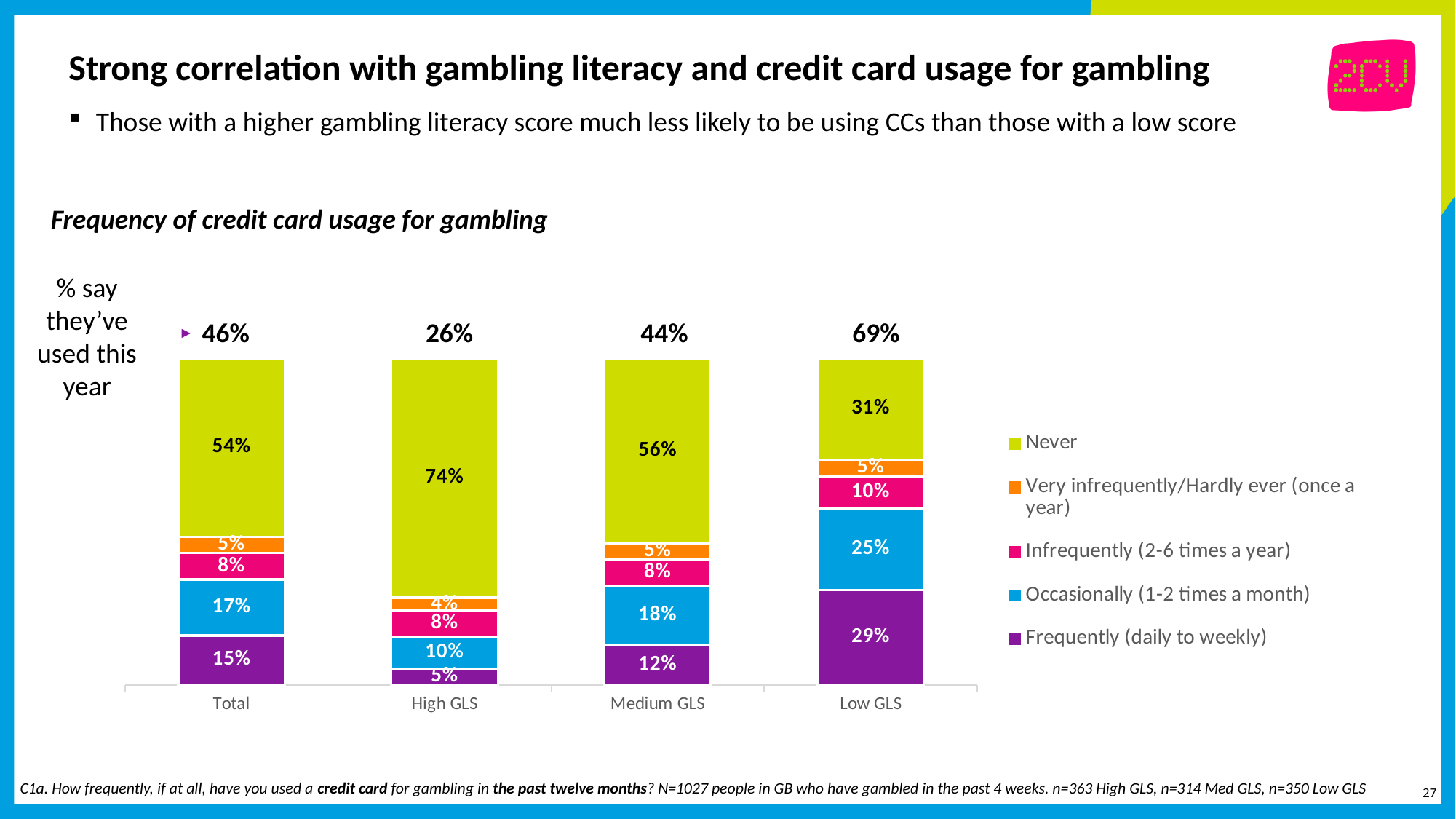
What percentage of the Low GLS group say they use a credit card for gambling Frequently (daily to weekly)? 29% Which group has the lowest Frequently (daily to weekly) value? High GLS What is the '% say they've used this year' figure shown above the Low GLS bar? 69% How many groups are shown along the x axis of the chart? 4 What is the difference between the Never values for High GLS and Low GLS? 43 percentage points Which legend entry is shown in purple? Frequently (daily to weekly) What kind of chart is shown on the slide? Stacked bar chart Which group has the highest '% say they've used this year' figure? Low GLS Is the Occasionally (1-2 times a month) value larger for Total or for Low GLS? Low GLS What percentage of the High GLS group answered Never? 74% How many series does the legend list? 5 What is the Occasionally (1-2 times a month) value for the Medium GLS group? 18%